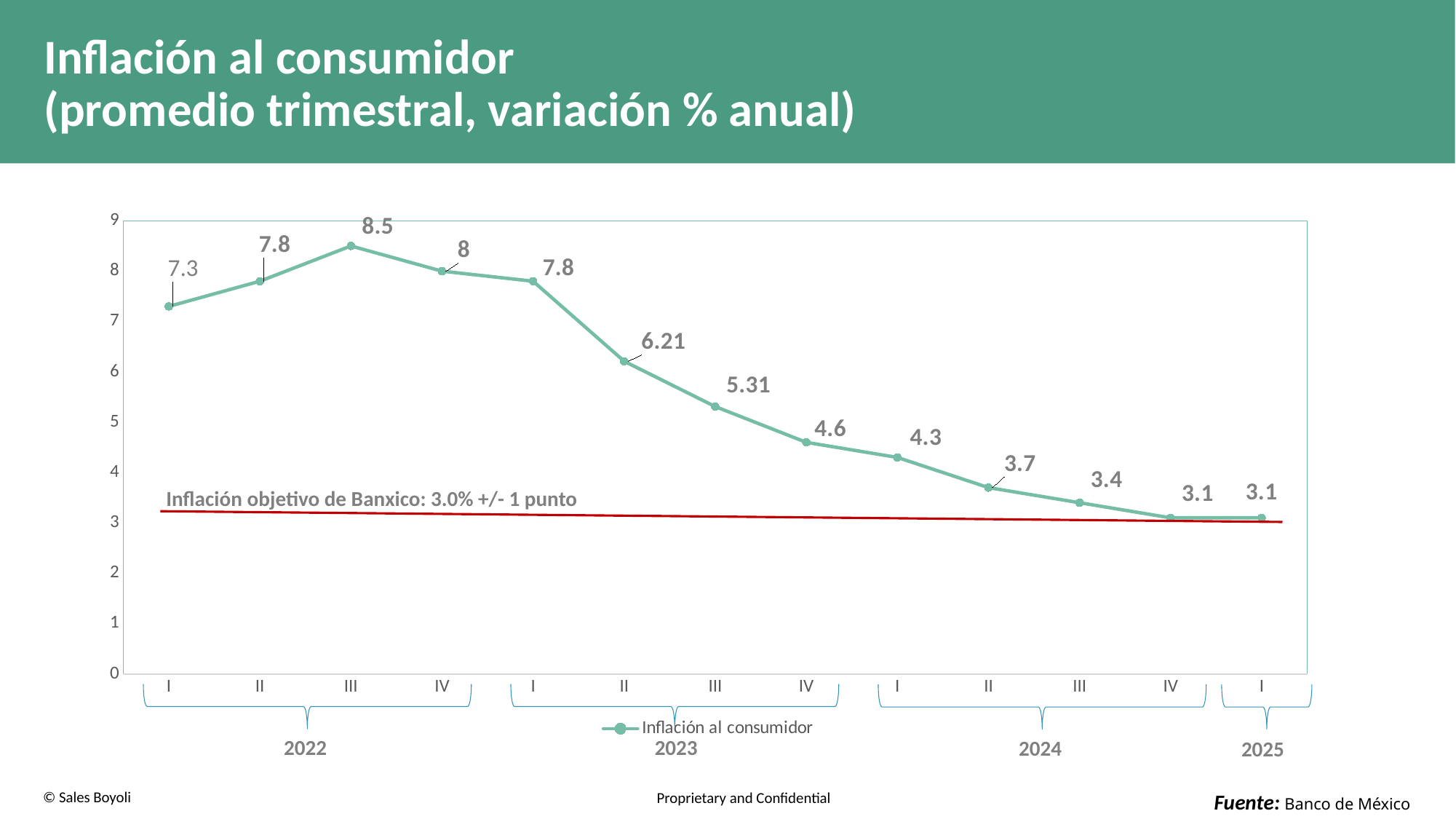
Which is larger, the consumer inflation value for quarter IV of 2023 or quarter I of 2024? IV 2023 What inflation target does the red line on the chart represent? 3.0% +/- 1 punto Which quarter has the highest consumer inflation value? III 2022 What is the difference between the consumer inflation values for quarter III of 2022 and quarter I of 2025? 5.4 What type of chart is shown on the slide? line chart Do the consumer inflation values generally rise or fall from quarter I of 2023 to quarter I of 2025? fall What is the consumer inflation value for quarter III of 2022? 8.5 How many quarterly data points are plotted on the chart? 13 What is the consumer inflation value for quarter II of 2023? 6.21 What is the consumer inflation value for quarter I of 2025? 3.1 What is the lowest consumer inflation value shown on the chart? 3.1 How many series does the legend list? 1